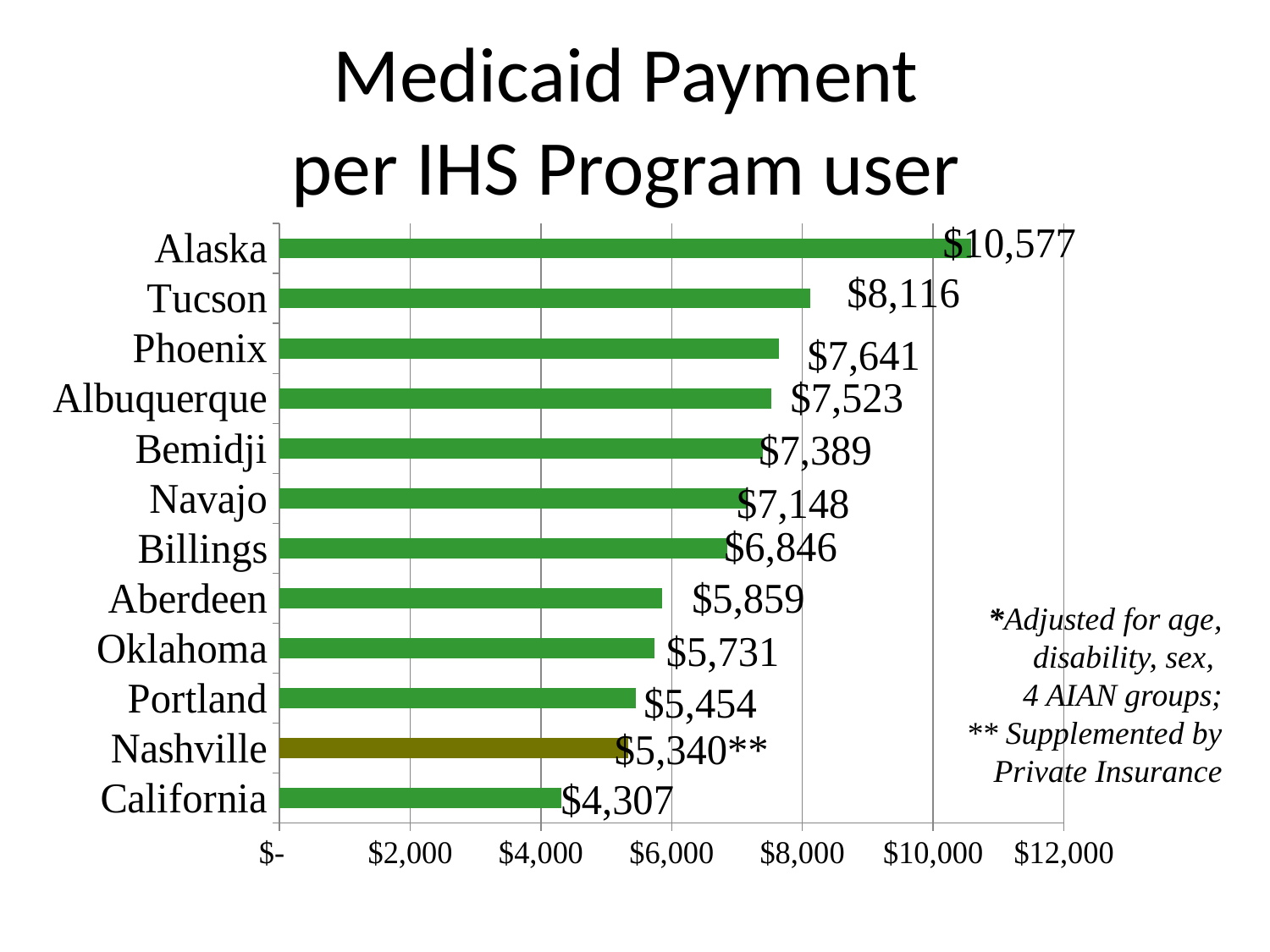
What is the difference between the Medicaid payment per IHS program user for Alaska and Tucson? $2,461 Which area has the highest Medicaid payment per IHS program user? Alaska Which area has the lowest Medicaid payment per IHS program user? California What is the difference between the Medicaid payment per IHS program user for Portland and California? $1,147 Is the Medicaid payment per IHS program user for Billings greater or less than $6,000? greater What is the Medicaid payment per IHS program user for Alaska? $10,577 How many areas are shown in the chart? 12 What is the Medicaid payment per IHS program user for Nashville? $5,340 Which has a higher Medicaid payment per IHS program user, Phoenix or Navajo? Phoenix What type of chart is shown on the slide? Bar chart Which bar in the chart is shown in a different colour from the others? Nashville What is the Medicaid payment per IHS program user for Bemidji? $7,389